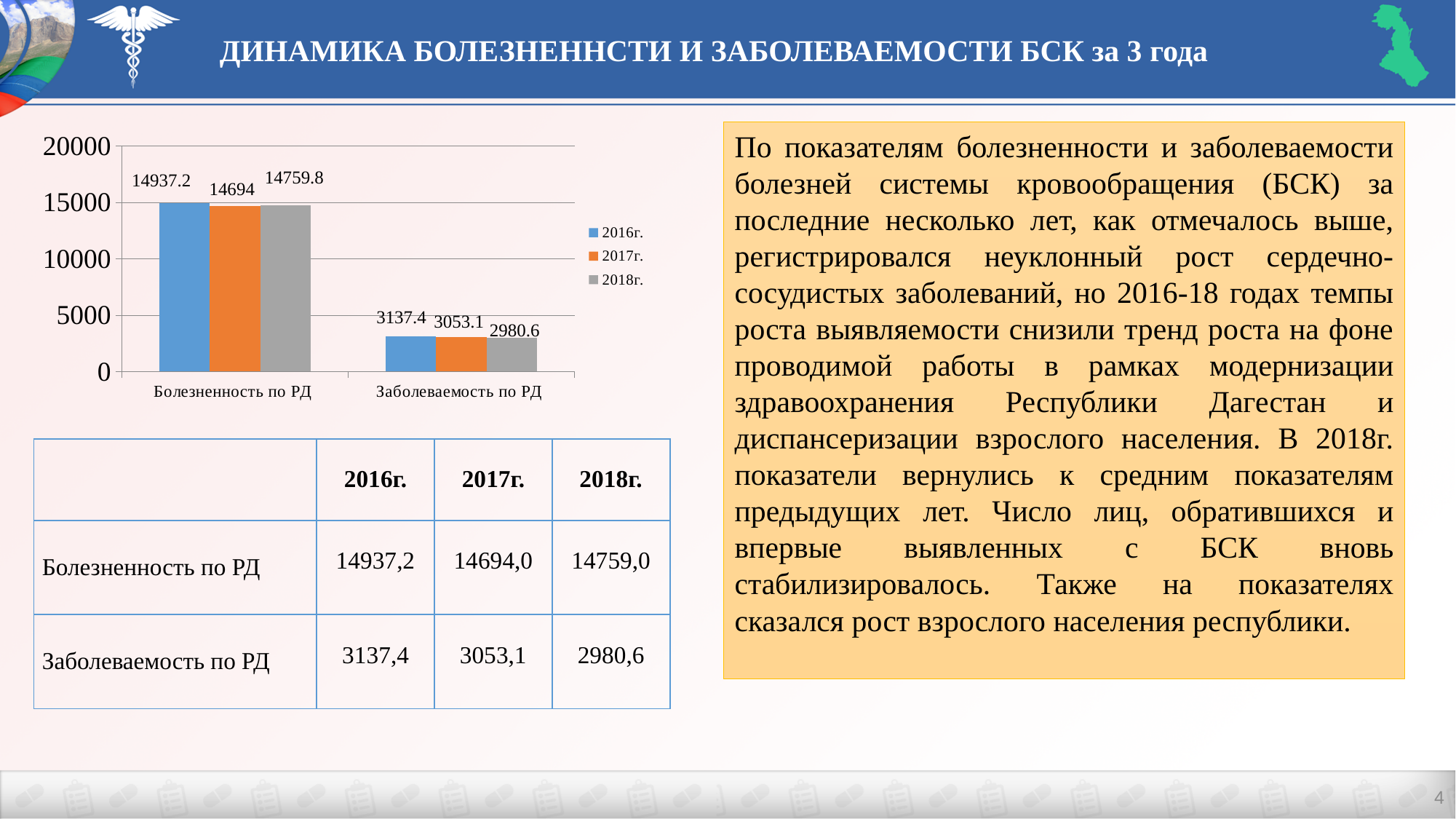
What is the value for 2018г. in the Заболеваемость по РД category? 2980.6 How many series does the legend list? 3 What is the difference between the 2016г. and 2017г. values for Болезненность по РД? 243.2 What is the value for 2017г. in the Болезненность по РД category? 14694 What is the value for 2017г. in the Заболеваемость по РД category? 3053.1 Which year has the lowest value in the Заболеваемость по РД category? 2018г. Do the values for Заболеваемость по РД rise or fall from 2016г. to 2018г.? fall What is the difference between the 2016г. and 2018г. values for Заболеваемость по РД? 156.8 What type of chart is shown on the slide? bar chart Which year has the highest value in the Болезненность по РД category? 2016г. What is the value for 2016г. in the Болезненность по РД category? 14937.2 Which is larger: the 2018г. value for Болезненность по РД or the 2017г. value for Болезненность по РД? 2018г. value for Болезненность по РД